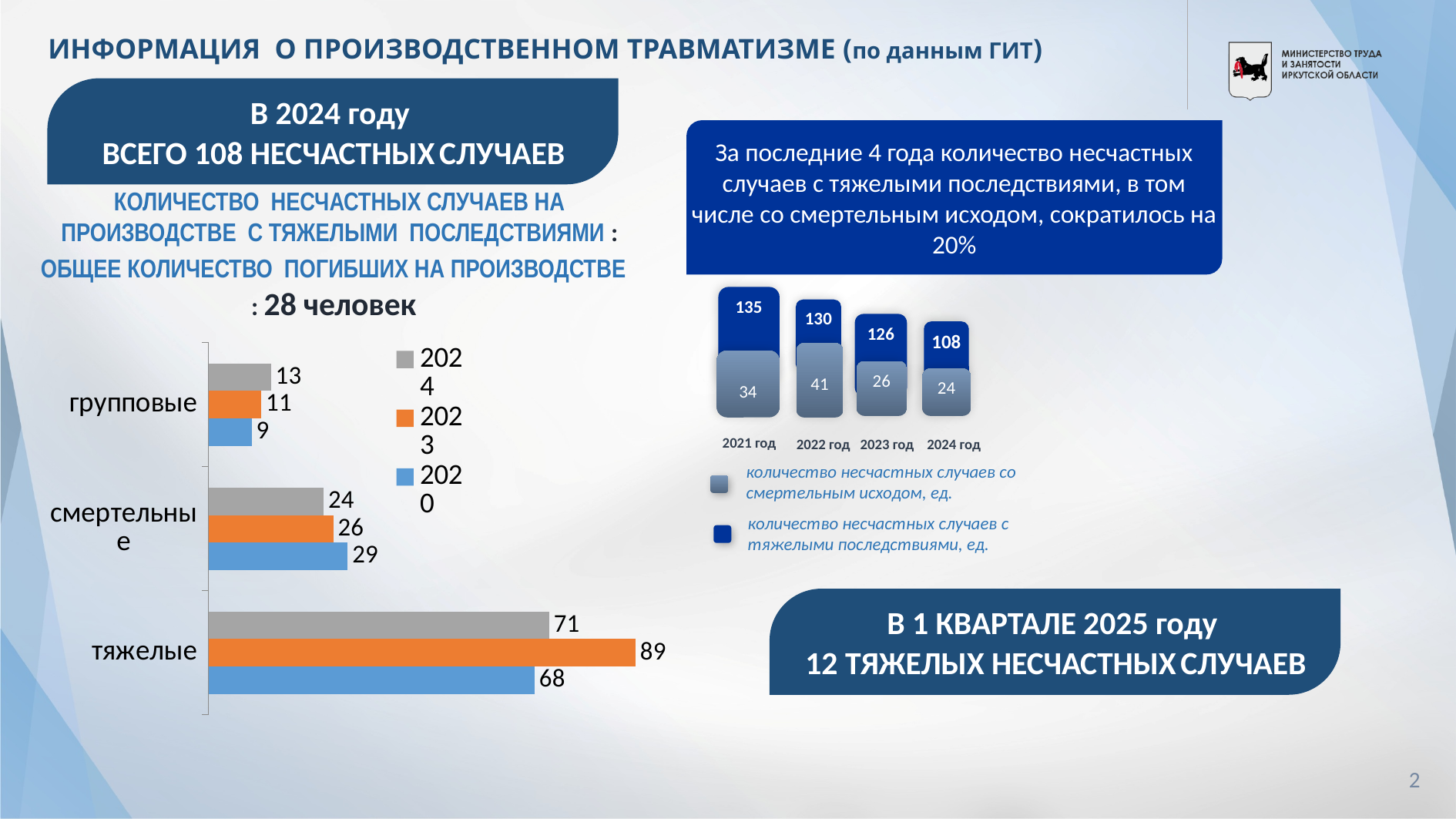
In the bar chart on the left of the slide, how many categories are shown? 3 In the bar chart on the left of the slide, which category has the lowest value in the 2023 series? групповые In the bar chart on the left of the slide, what is the difference between the 2023 and 2024 values for тяжелые? 18 In the chart on the right of the slide, which year has the highest number of fatal accidents (со смертельным исходом)? 2022 год In the bar chart on the left of the slide, which is larger for смертельные: the 2020 value or the 2024 value? 2020 In the bar chart on the left of the slide, which category has the highest value in the 2024 series? тяжелые In the bar chart on the left of the slide, what is the value for тяжелые in the 2023 series? 89 What kind of chart is shown on the left of the slide? bar chart In the bar chart on the left of the slide, how many series does the legend list? 3 In the bar chart on the left of the slide, what is the value for смертельные in the 2024 series? 24 In the chart on the right of the slide, what is the number of accidents with severe consequences (тяжелыми последствиями) in 2022? 130 In the bar chart on the left of the slide, what is the value for групповые in the 2020 series? 9